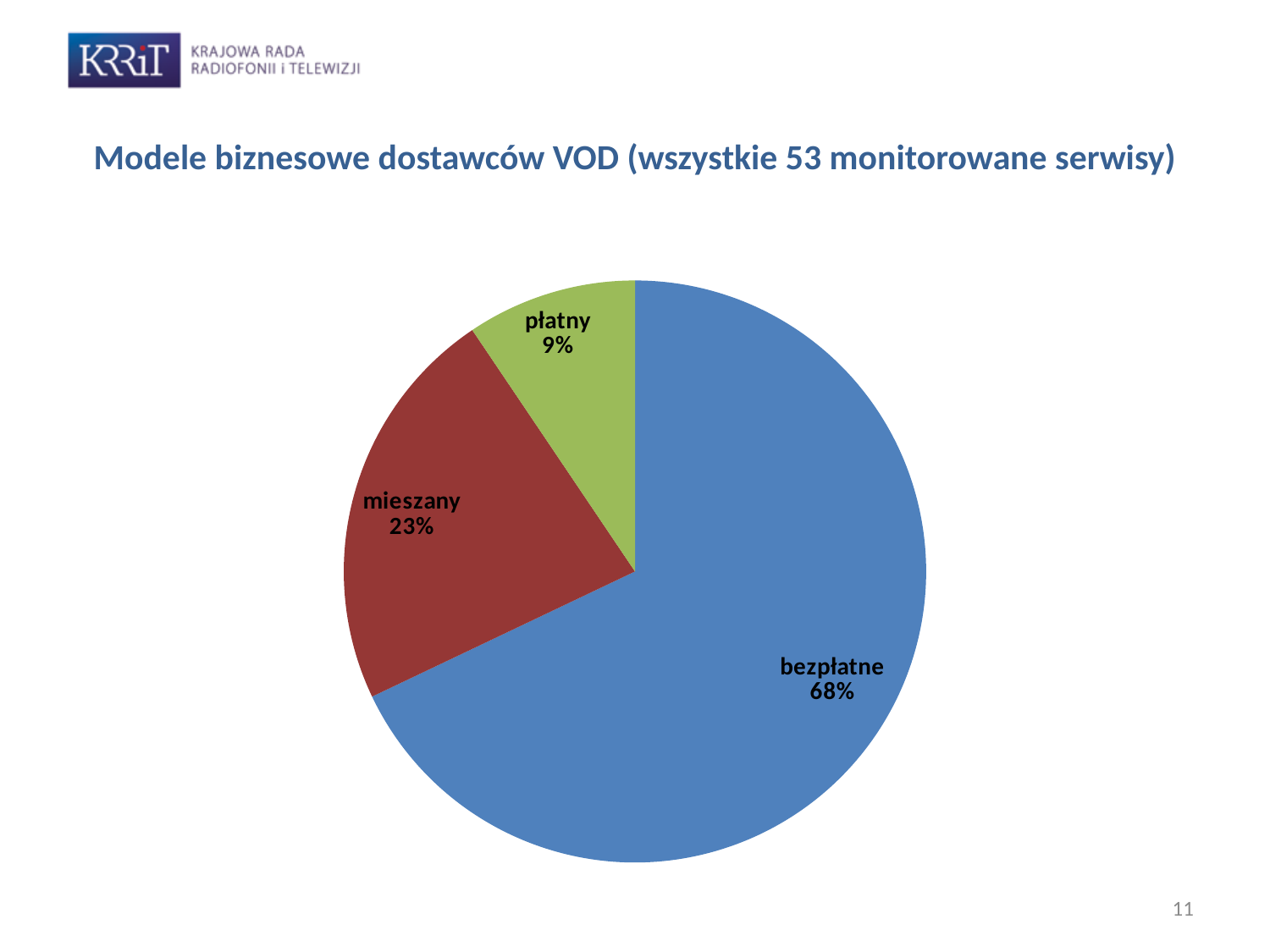
What type of chart is shown on the slide? pie chart Which business model has the largest share in the pie chart? bezpłatne Which slice is larger, 'mieszany' or 'płatny'? mieszany How many slices does the pie chart have? 3 What share of the pie does the 'bezpłatne' slice represent? 68% What share of the pie does the 'mieszany' slice represent? 23% What is the difference in percentage points between the 'mieszany' and 'płatny' slices? 14 What share of the pie does the 'płatny' slice represent? 9% What is the title of the chart on the slide? Modele biznesowe dostawców VOD (wszystkie 53 monitorowane serwisy) Which business model has the smallest share in the pie chart? płatny What is the difference in percentage points between the 'bezpłatne' and 'mieszany' slices? 45 What colour is the 'bezpłatne' slice? blue